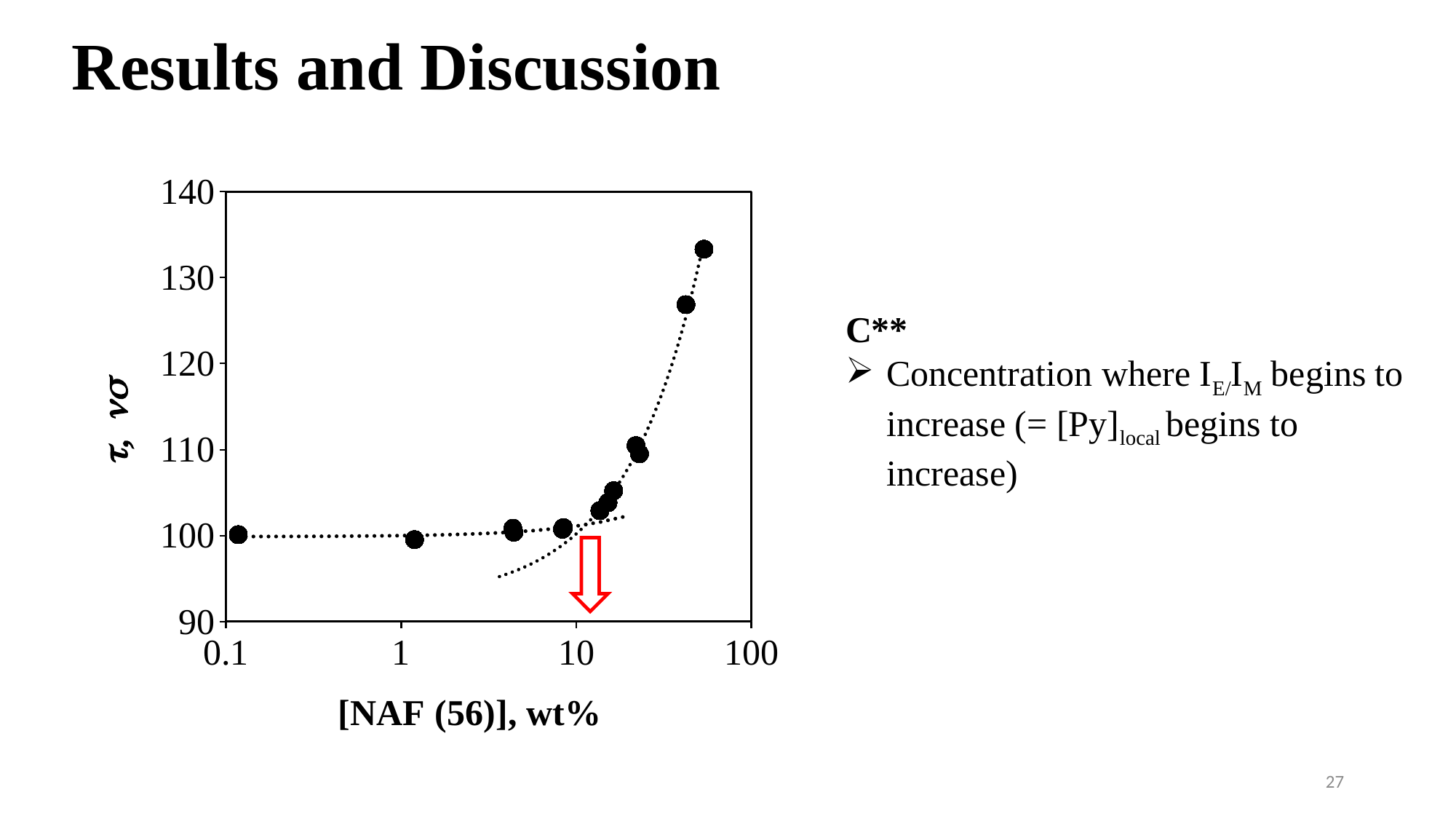
Is the value of the plotted point near 20 wt% greater or less than 100? greater What is the label of the y axis of the chart? τ, νσ Which plotted point has the highest value: the leftmost point or the rightmost point? the rightmost point Is the value of the highest plotted point greater or less than 140? less Is the value of the leftmost plotted point (at about 0.1 wt%) greater or less than 110? less What is the label of the x axis of the chart? [NAF (56)], wt% Do the plotted values rise or fall as [NAF (56)] increases along the x axis? rise What is the lowest value shown on the y axis of the chart? 90 What kind of chart is shown on the slide? scatter chart